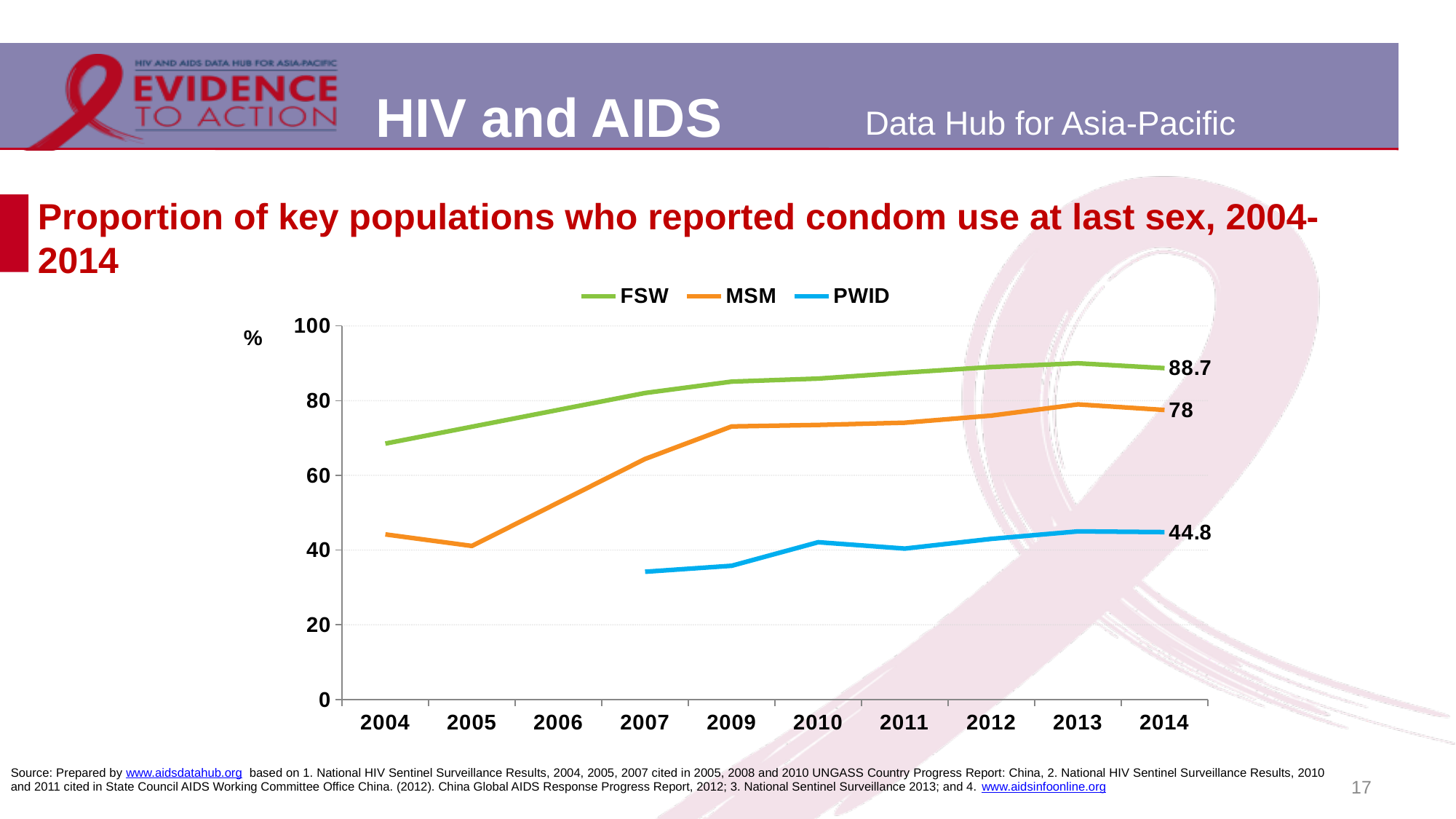
How many years are shown on the x axis? 10 How many series does the legend list? 3 What is the difference between the FSW and MSM values in 2014? 10.7 Is the value for MSM in 2004 greater or less than 60? less Does the FSW line generally rise or fall from 2004 to 2013? rise What is the value for FSW in 2014? 88.7 What type of chart is shown on the slide? line chart What is the value for PWID in 2014? 44.8 Which series has the highest value in 2014? FSW What is the value for MSM in 2014? 78 Which series has the lowest value in 2014? PWID Is the value for FSW in 2004 greater or less than 60? greater